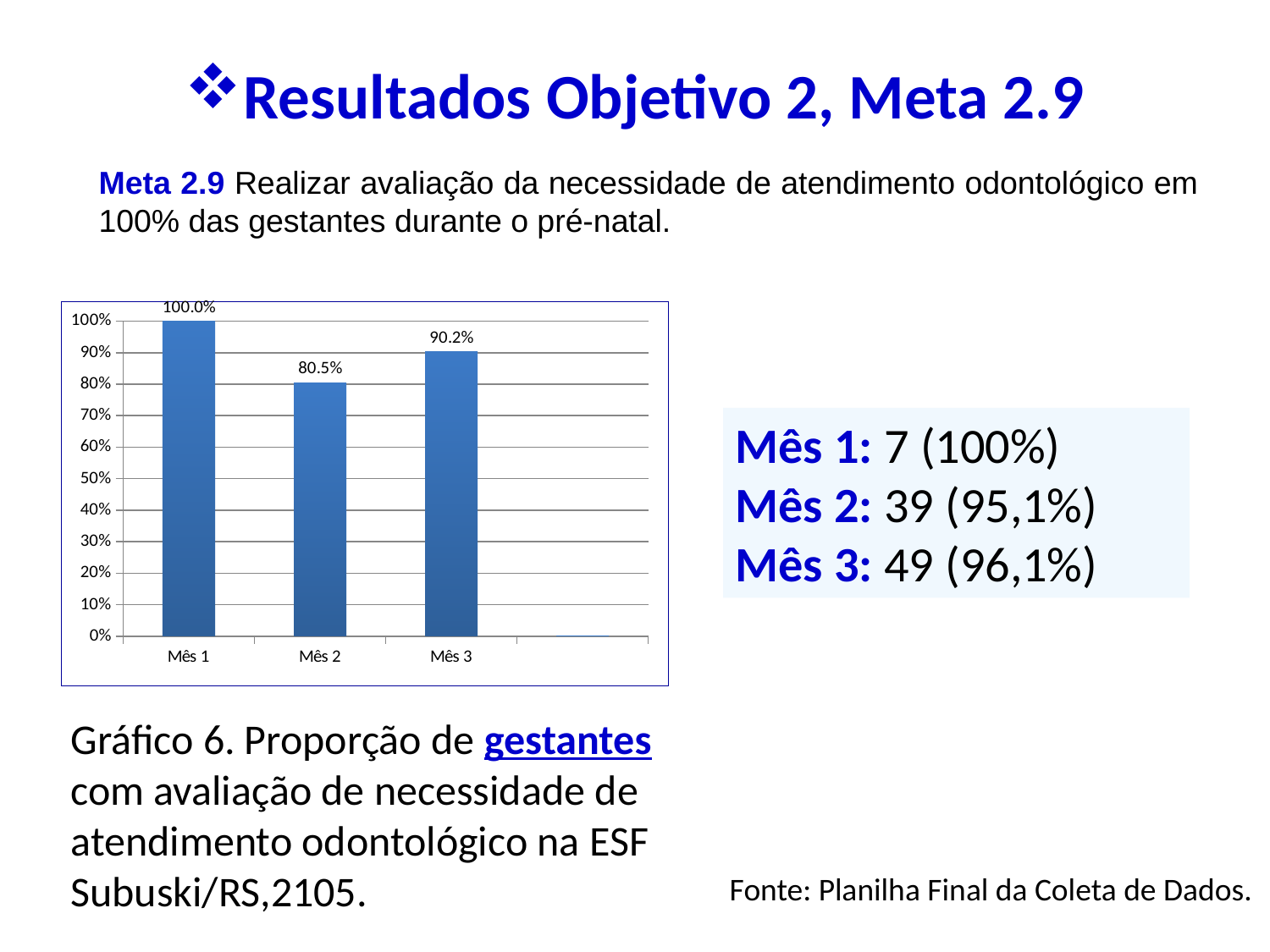
What is the value shown for Mês 2? 80.5% How many months (categories) are shown in the chart? 3 What is the value shown for Mês 3? 90.2% What is the value shown for Mês 1? 100.0% Which month has the highest value in the chart? Mês 1 What kind of chart is shown on the slide? bar chart What is the highest tick value shown on the vertical axis of the chart? 100% What is the difference between the values for Mês 3 and Mês 2? 9.7% Is the value for Mês 2 greater or less than 90%? less Which is larger, the value for Mês 2 or the value for Mês 3? Mês 3 What is the difference between the values for Mês 1 and Mês 2? 19.5% Which month has the lowest value in the chart? Mês 2